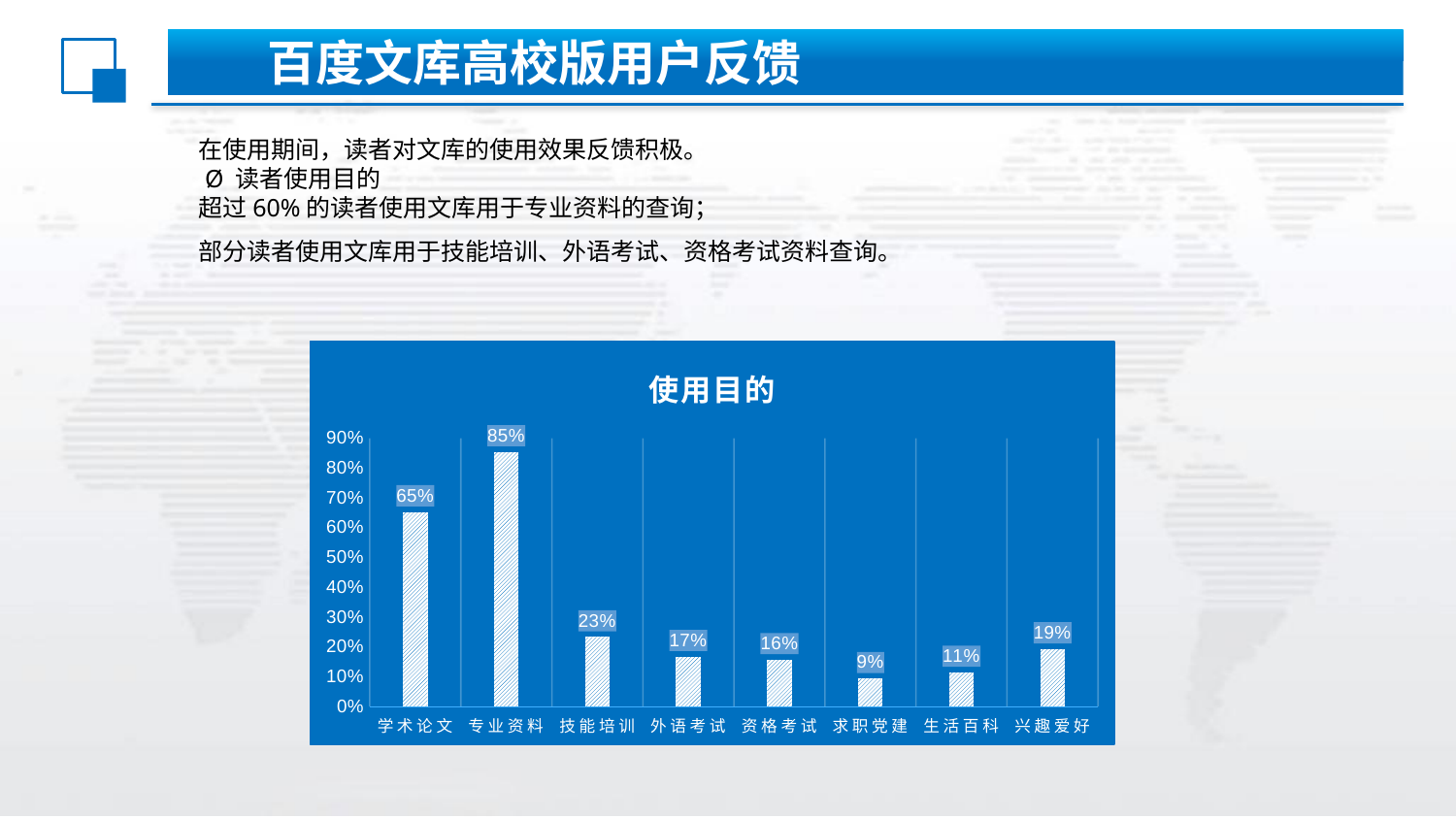
Which category has the lowest value? 求职党建 What kind of chart is shown? bar chart What is the value for 学术论文? 65% What is the difference between the values for 专业资料 and 学术论文? 20% What is the title of the chart? 使用目的 What is the value for 兴趣爱好? 19% Which is larger, the value for 技能培训 or the value for 外语考试? 技能培训 Is the value for 生活百科 greater or less than 20%? less What is the value for 专业资料? 85% How many categories are shown on the x axis? 8 What is the value for 求职党建? 9% Which category has the highest value? 专业资料